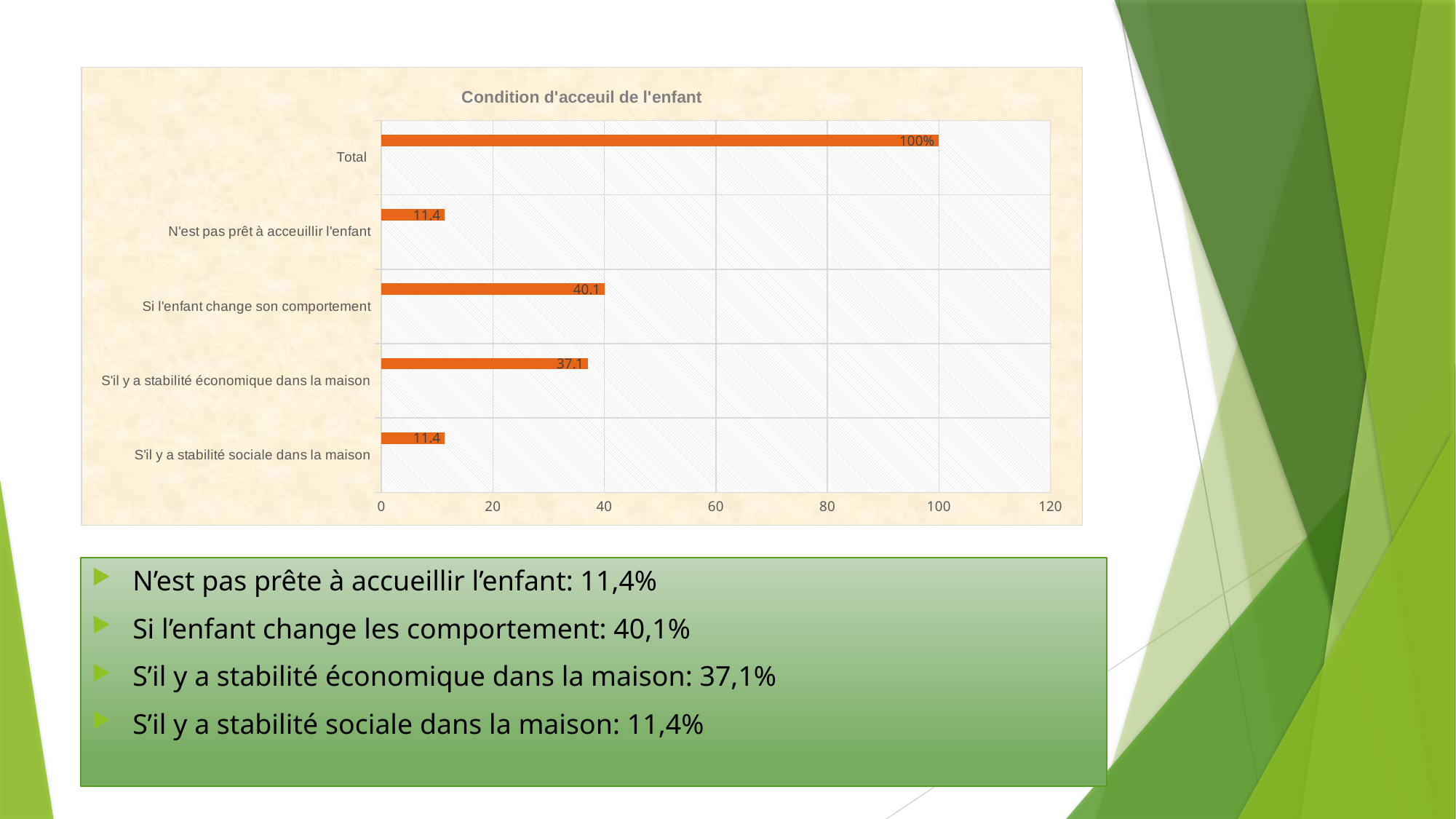
Which category has the highest value? Total What is the value for "N'est pas prêt à acceuillir l'enfant"? 11.4 Which is larger: the value for "S'il y a stabilité économique dans la maison" or the value for "S'il y a stabilité sociale dans la maison"? S'il y a stabilité économique dans la maison What data label is shown on the "Total" bar? 100% What is the value for "S'il y a stabilité économique dans la maison"? 37.1 Is the value for "Si l'enfant change son comportement" greater or less than 60? less How many categories are shown on the chart? 5 What is the value for "Si l'enfant change son comportement"? 40.1 What type of chart is shown on the slide? bar chart What is the value for "S'il y a stabilité sociale dans la maison"? 11.4 What is the difference between the values for "Si l'enfant change son comportement" and "S'il y a stabilité économique dans la maison"? 3.0 Excluding Total, which category has the highest value? Si l'enfant change son comportement